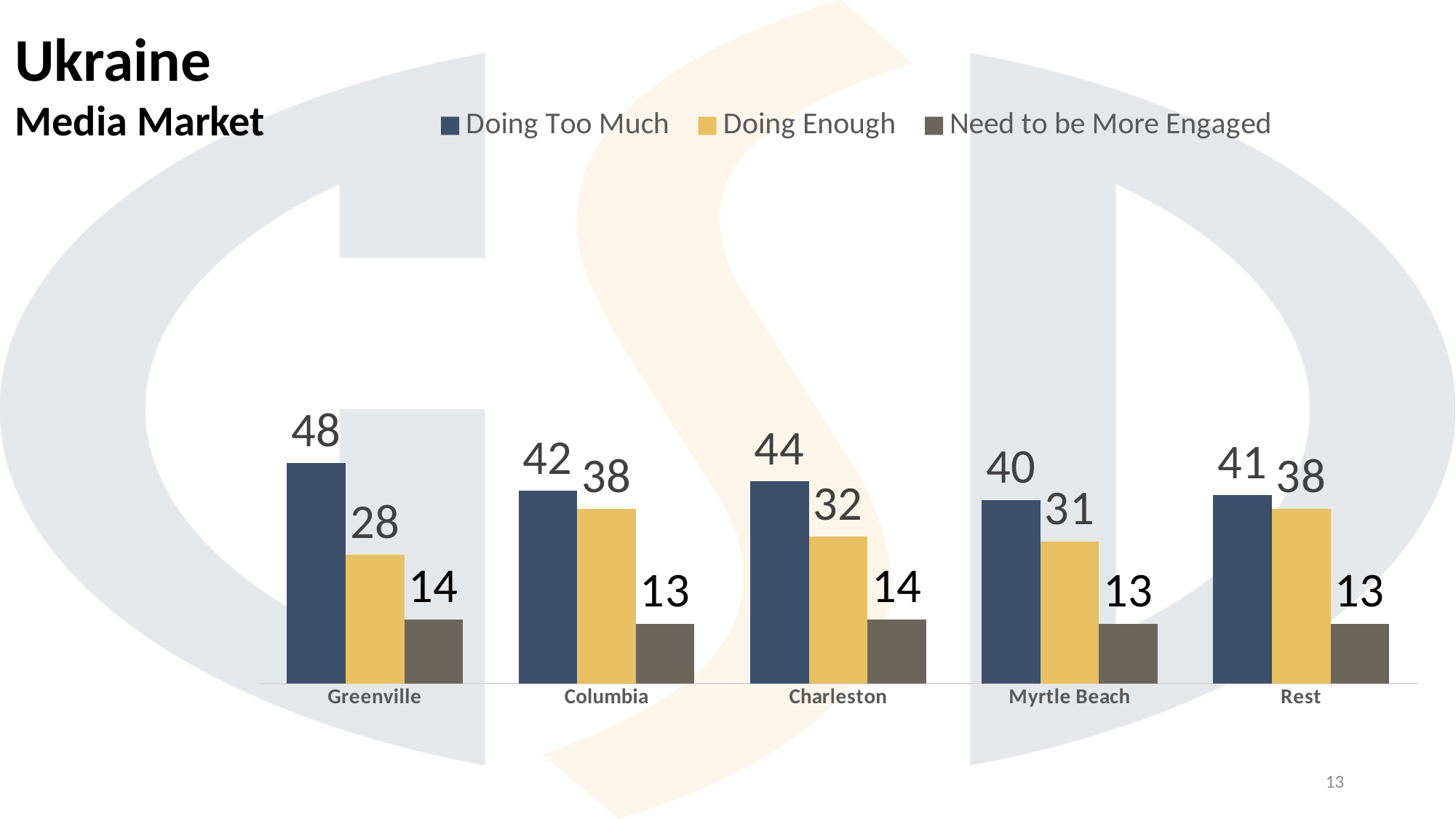
Which media market has the highest value for "Doing Too Much"? Greenville Which colour represents "Doing Enough" in the legend? Yellow How many series does the legend list? 3 What is the difference between "Doing Enough" in Columbia and in Charleston? 6 What is the value for "Doing Enough" in Myrtle Beach? 31 What is the difference between "Doing Too Much" and "Doing Enough" in Greenville? 20 Which media market has the lowest value for "Doing Enough"? Greenville What is the value for "Doing Too Much" in Greenville? 48 Which is larger in Columbia: "Doing Too Much" or "Doing Enough"? Doing Too Much How many media markets are shown on the x axis? 5 What is the value for "Need to be More Engaged" in Charleston? 14 What kind of chart is shown on the slide? Bar chart